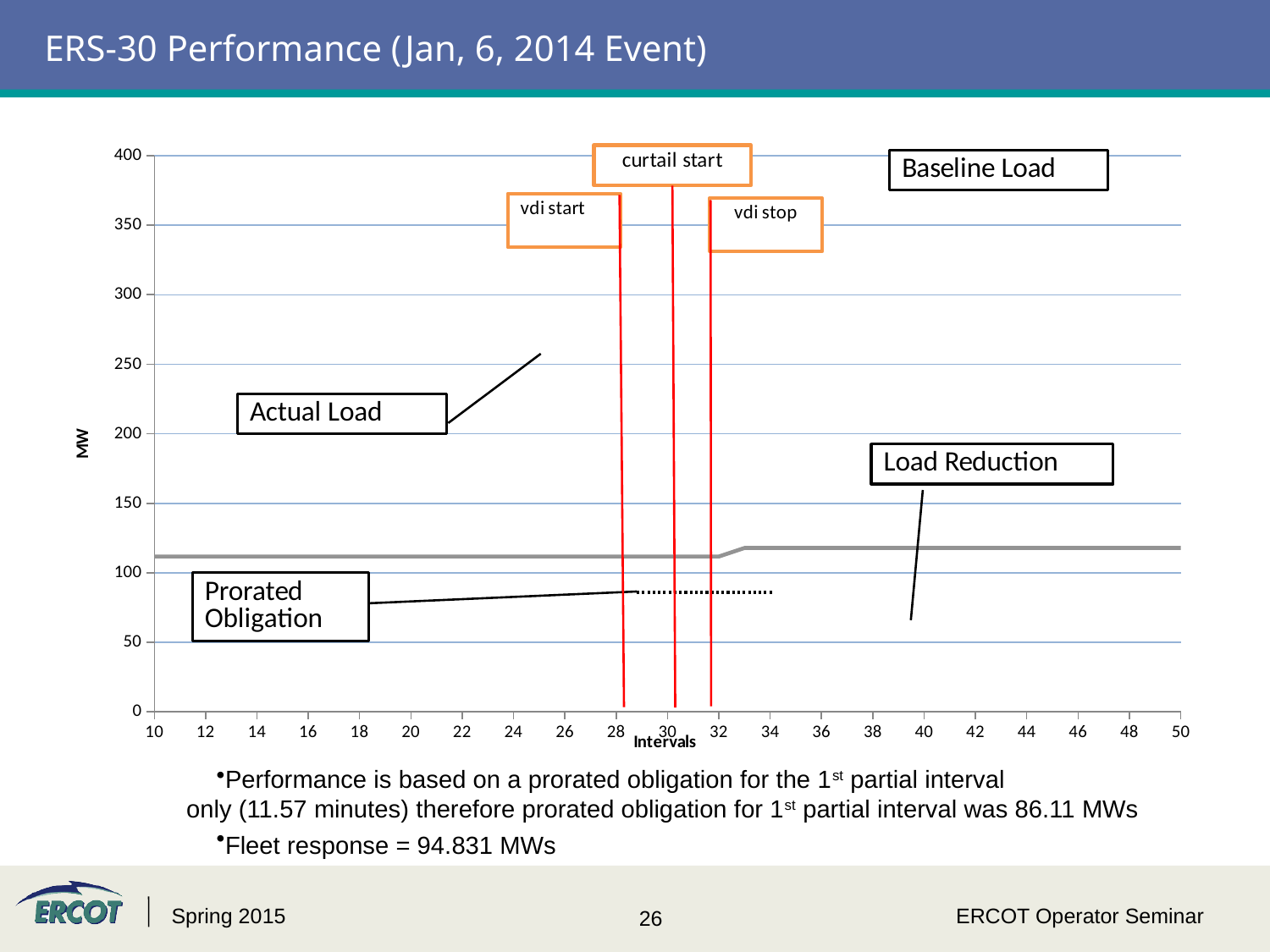
Is the value of the gray load line at interval 20 greater or less than 100? greater Is the gray load line higher at interval 40 or at interval 20? interval 40 What is the label on the vertical axis of the chart? MW What is the label on the horizontal axis of the chart? Intervals Is the dotted Prorated Obligation line greater or less than 50 MW? greater Is the dotted Prorated Obligation line greater or less than 100 MW? less Is the dotted Prorated Obligation line above or below the gray load line? below Does the gray load line rise or fall between interval 30 and interval 34? rises What kind of chart is shown on the slide? line chart